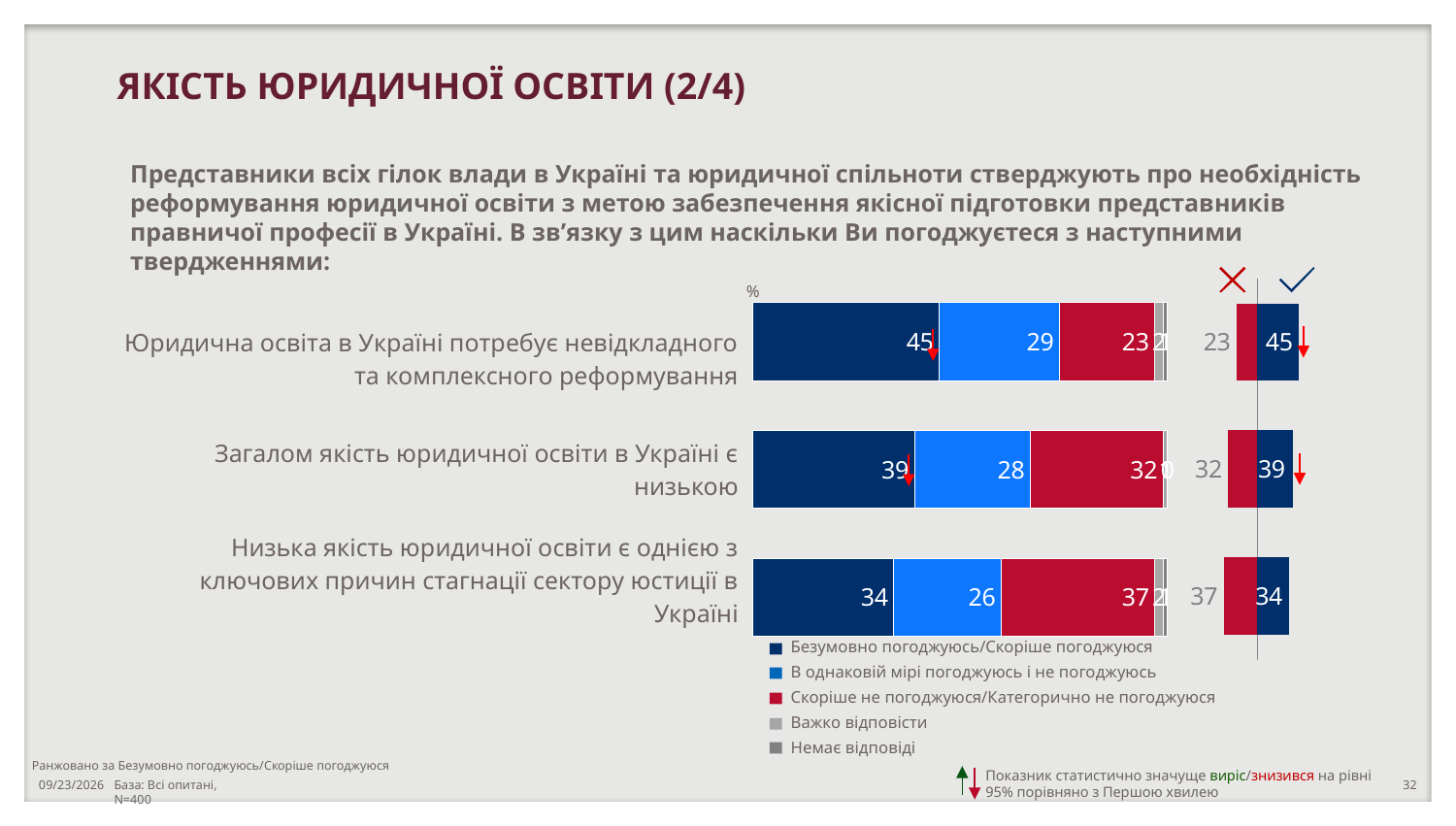
Which statement has the lowest value for 'В однаковій мірі погоджуюсь і не погоджуюсь'? Низька якість юридичної освіти є однією з ключових причин стагнації сектору юстиції в Україні What is the value of 'Скоріше не погоджуюся/Категорично не погоджуюся' for 'Низька якість юридичної освіти є однією з ключових причин стагнації сектору юстиції в Україні'? 37 What is the value of 'В однаковій мірі погоджуюсь і не погоджуюсь' for 'Загалом якість юридичної освіти в Україні є низькою'? 28 What is the difference between the 'Безумовно погоджуюсь/Скоріше погоджуюся' values for the first statement (45) and the third statement (34)? 11 What is the value of 'Безумовно погоджуюсь/Скоріше погоджуюся' for 'Юридична освіта в Україні потребує невідкладного та комплексного реформування'? 45 What is the value of 'Скоріше не погоджуюся/Категорично не погоджуюся' for 'Загалом якість юридичної освіти в Україні є низькою'? 32 For 'Низька якість юридичної освіти є однією з ключових причин стагнації сектору юстиції в Україні', which is larger: 'Безумовно погоджуюсь/Скоріше погоджуюся' or 'Скоріше не погоджуюся/Категорично не погоджуюся'? Скоріше не погоджуюся/Категорично не погоджуюся How many statements (categories) are plotted in the chart? 3 What is the title of the slide? ЯКІСТЬ ЮРИДИЧНОЇ ОСВІТИ (2/4) What type of chart is shown on the slide? stacked bar chart Which statement has the highest value for 'Безумовно погоджуюсь/Скоріше погоджуюся'? Юридична освіта в Україні потребує невідкладного та комплексного реформування How many legend entries does the chart list? 5